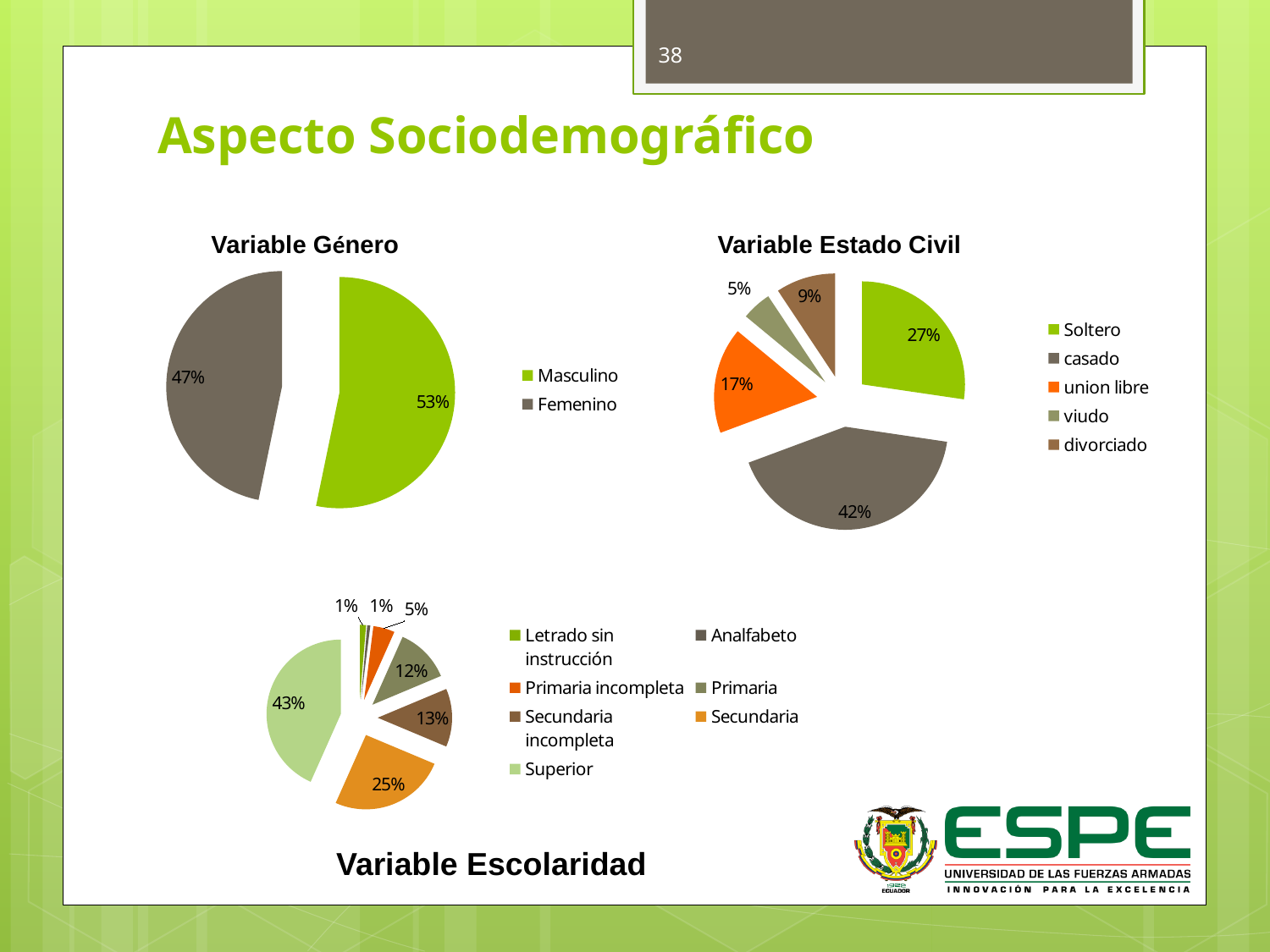
In the Variable Género chart, what percentage is Masculino? 53% In the Variable Escolaridad chart, what percentage is Secundaria? 25% In the Variable Escolaridad chart, which category has the largest share? Superior In the Variable Género chart, what percentage is Femenino? 47% What kind of chart is the Variable Género chart? pie chart How many categories does the legend of the Variable Escolaridad chart list? 7 In the Variable Estado Civil chart, what is the difference between the Soltero and union libre shares? 10% In the Variable Estado Civil chart, what percentage is casado? 42% In the Variable Escolaridad chart, what percentage is Superior? 43% In the Variable Estado Civil chart, which is larger, Soltero or divorciado? Soltero How many categories does the legend of the Variable Estado Civil chart list? 5 In the Variable Estado Civil chart, which category has the smallest share? viudo